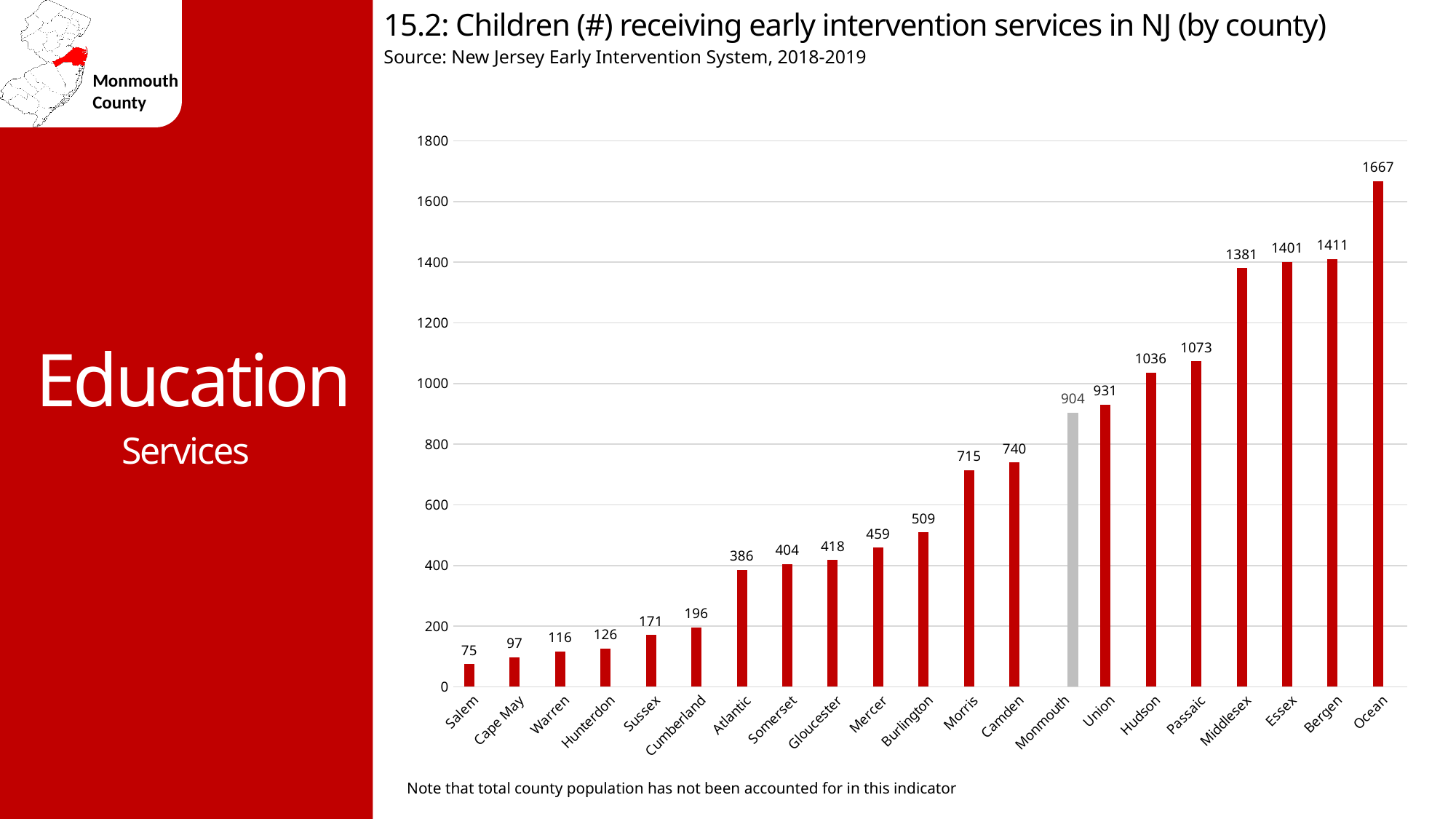
How many counties are shown on the chart? 21 What is the value shown for Hunterdon County? 126 What is the value shown for Ocean County? 1667 Which county has a larger value, Hudson or Passaic? Passaic Which county's bar is coloured grey instead of red? Monmouth What kind of chart is shown on the slide? Bar chart Which county has the lowest number of children receiving early intervention services? Salem How many children received early intervention services in Monmouth County? 904 What is the difference between the values for Bergen and Essex? 10 What is the difference between the values for Ocean and Monmouth? 763 Which county has the highest number of children receiving early intervention services? Ocean Do the values rise or fall moving from left to right along the x axis? Rise